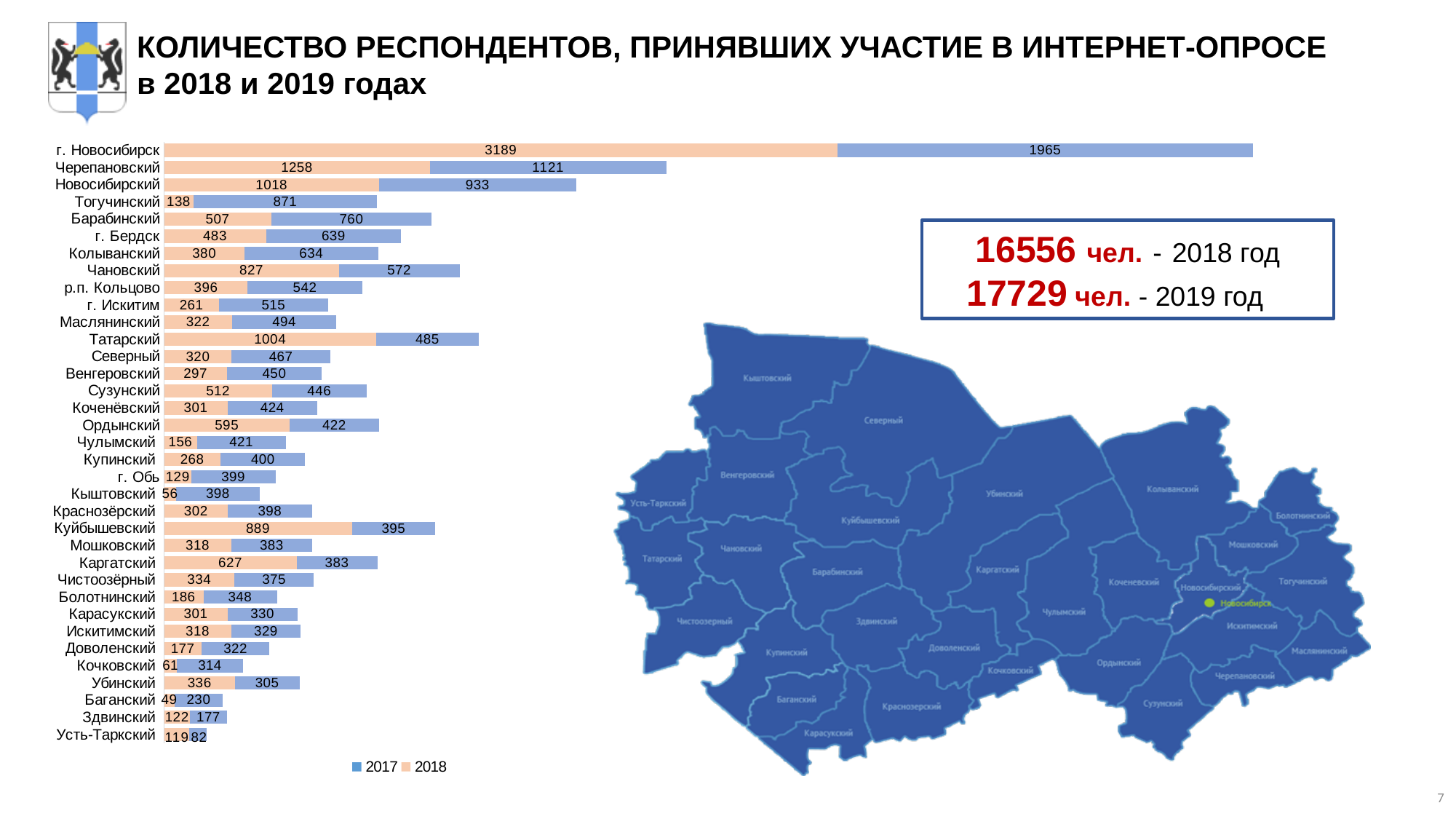
How many series does the legend list? 2 What is the total of the stacked bar for Черепановский? 2379 Which category has the highest 2017 value? г. Новосибирск What kind of chart is shown on the slide? Bar chart What is the 2018 value for г. Новосибирск? 3189 How many categories are shown in the chart? 35 What is the 2018 value for Куйбышевский? 889 Which category has the lowest 2018 value? Баганский Which category has the lowest 2017 value? Усть-Таркский What is the 2017 value for Черепановский? 1121 What is the difference between the 2018 and 2017 values for г. Новосибирск? 1224 For Татарский, which series has the larger value, 2017 or 2018? 2018